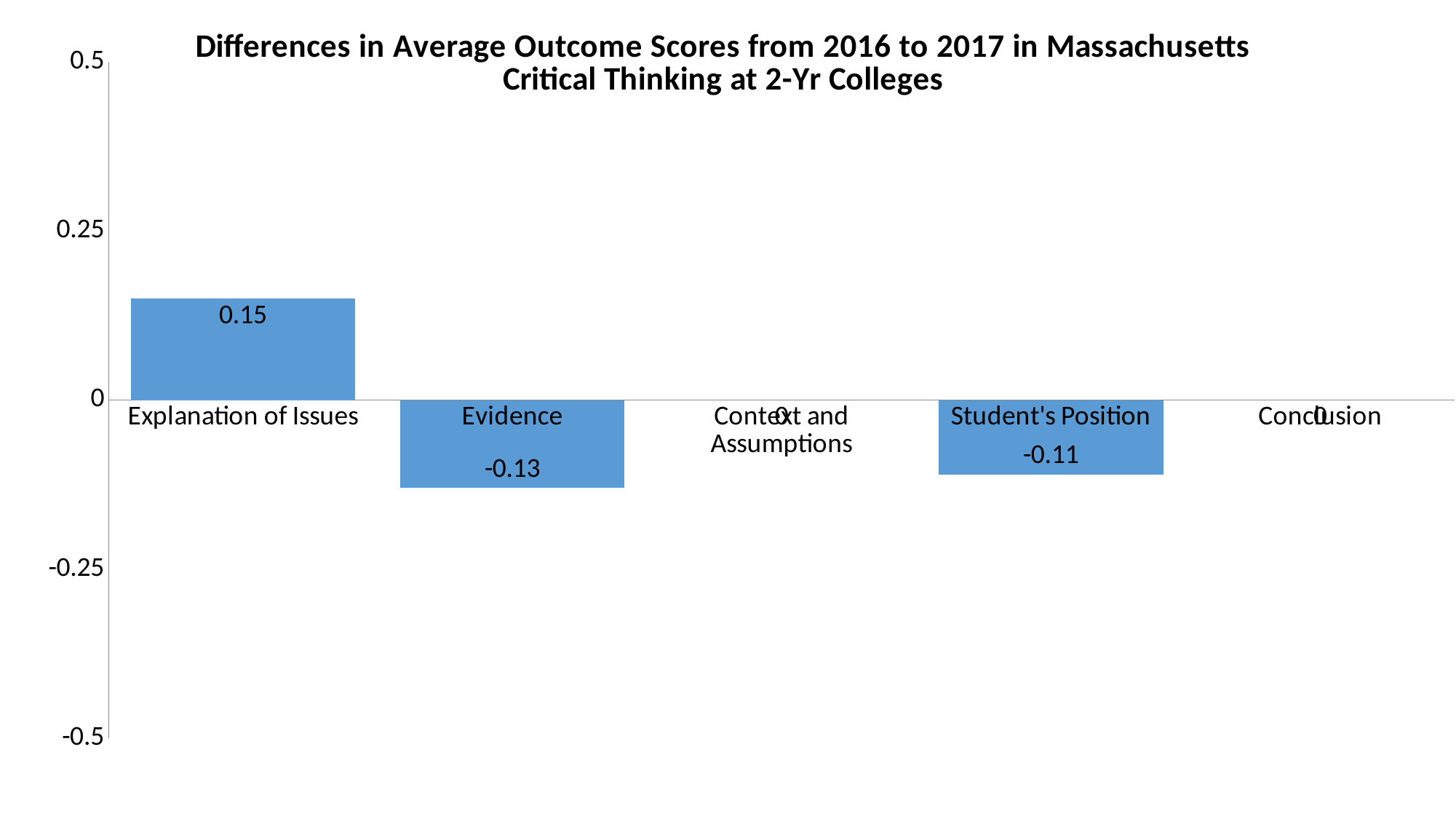
What is the value for Evidence? -0.13 What is the value for Context and Assumptions? 0 Which category has the lowest value? Evidence Is the value for Explanation of Issues greater or less than 0.25? less What is the value for Explanation of Issues? 0.15 How many categories are shown on the x axis? 5 What is the difference between the values for Explanation of Issues and Evidence? 0.28 What kind of chart is this? bar chart Which is larger, the value for Student's Position or the value for Evidence? Student's Position What is the title of the chart? Differences in Average Outcome Scores from 2016 to 2017 in Massachusetts Critical Thinking at 2-Yr Colleges Which category has the highest value? Explanation of Issues What is the value for Student's Position? -0.11